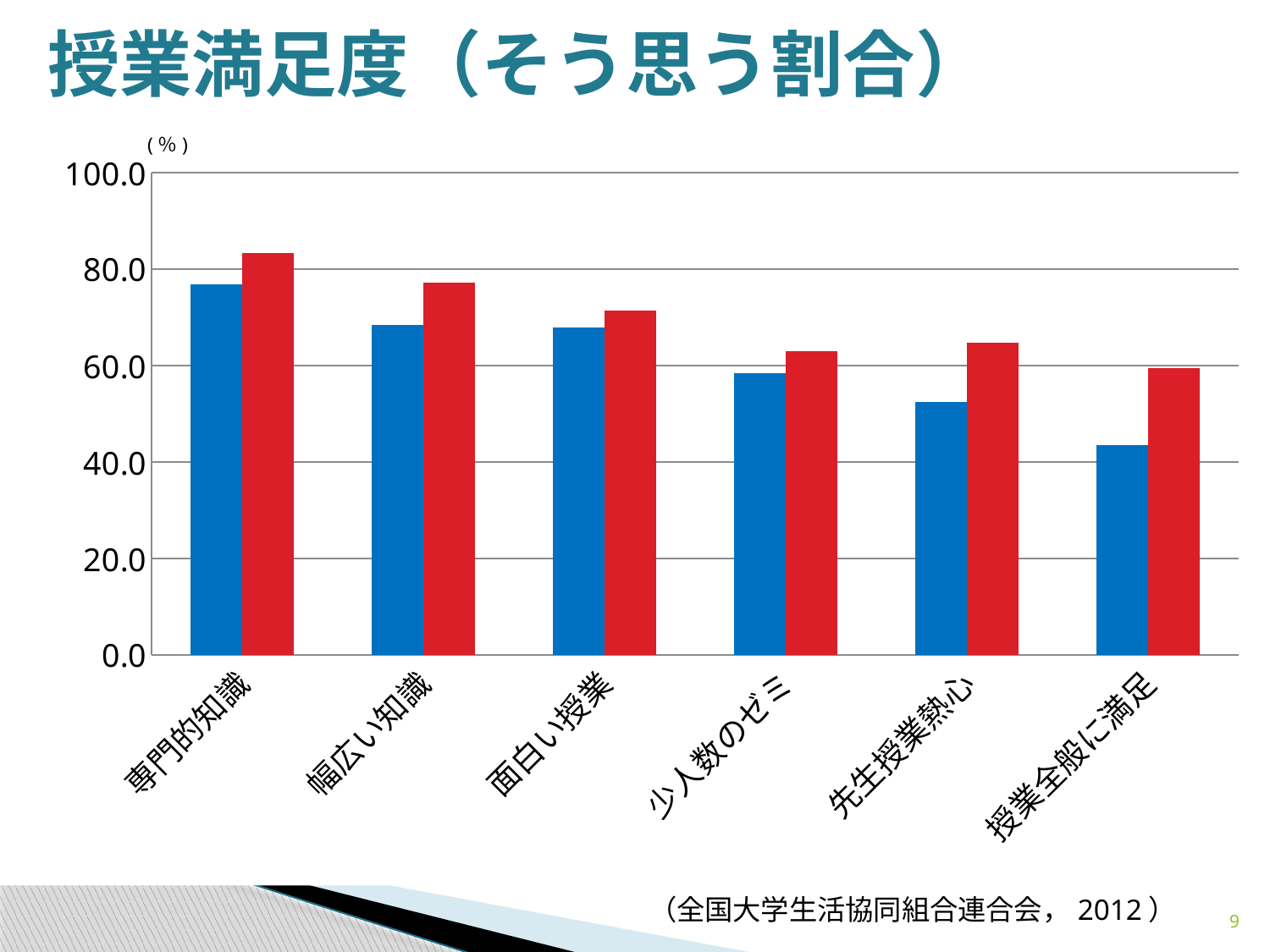
Is the blue bar for 専門的知識 greater or less than 60.0? greater What unit is indicated at the top of the y axis? (%) Is the red bar for 専門的知識 greater or less than 80.0? greater For 先生授業熱心, which bar is taller, the blue one or the red one? the red one Which category has the tallest red bar? 専門的知識 How many categories are shown on the x axis of the chart? 6 How many bars are plotted for each category in the chart? 2 Is the blue bar for 授業全般に満足 greater or less than 60.0? less Do the blue bars rise or fall from left to right across the categories? fall Which category has the tallest blue bar? 専門的知識 Which category has the shortest blue bar? 授業全般に満足 What kind of chart is shown on the slide? bar chart